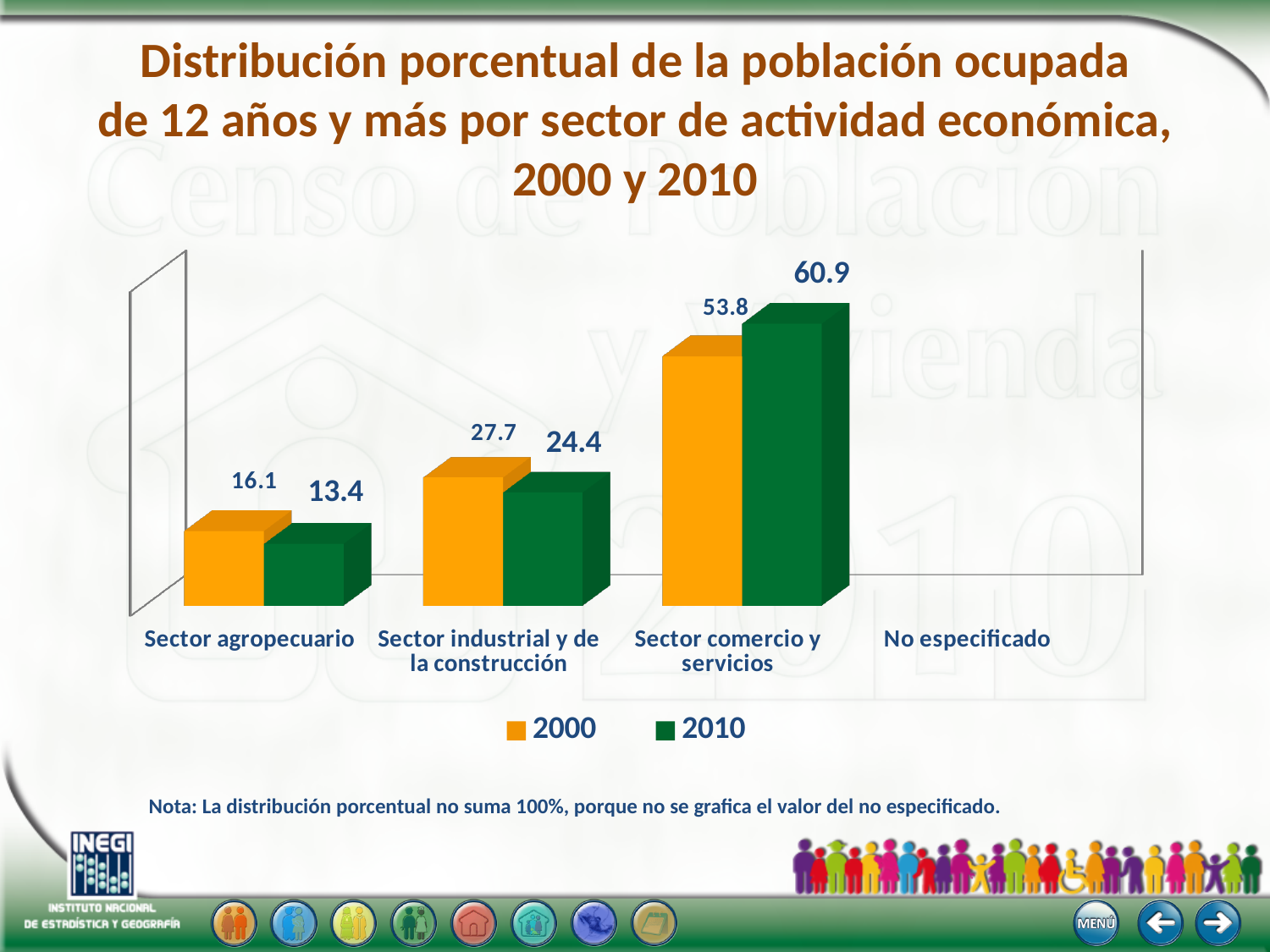
Which sector has the highest value in 2010? Sector comercio y servicios What is the value for Sector agropecuario in 2000? 16.1 Which colour represents the year 2010 in the legend? Green What is the difference between the 2000 and 2010 values for Sector industrial y de la construcción? 3.3 Which sector has the lowest value in 2000? Sector agropecuario What kind of chart is shown on the slide? Bar chart What is the value for Sector industrial y de la construcción in 2010? 24.4 Which is larger for Sector agropecuario, the 2000 value or the 2010 value? 2000 How many category labels are shown along the horizontal axis? 4 What is the value for Sector comercio y servicios in 2010? 60.9 How many series does the legend list? 2 What is the difference between the 2010 and 2000 values for Sector comercio y servicios? 7.1